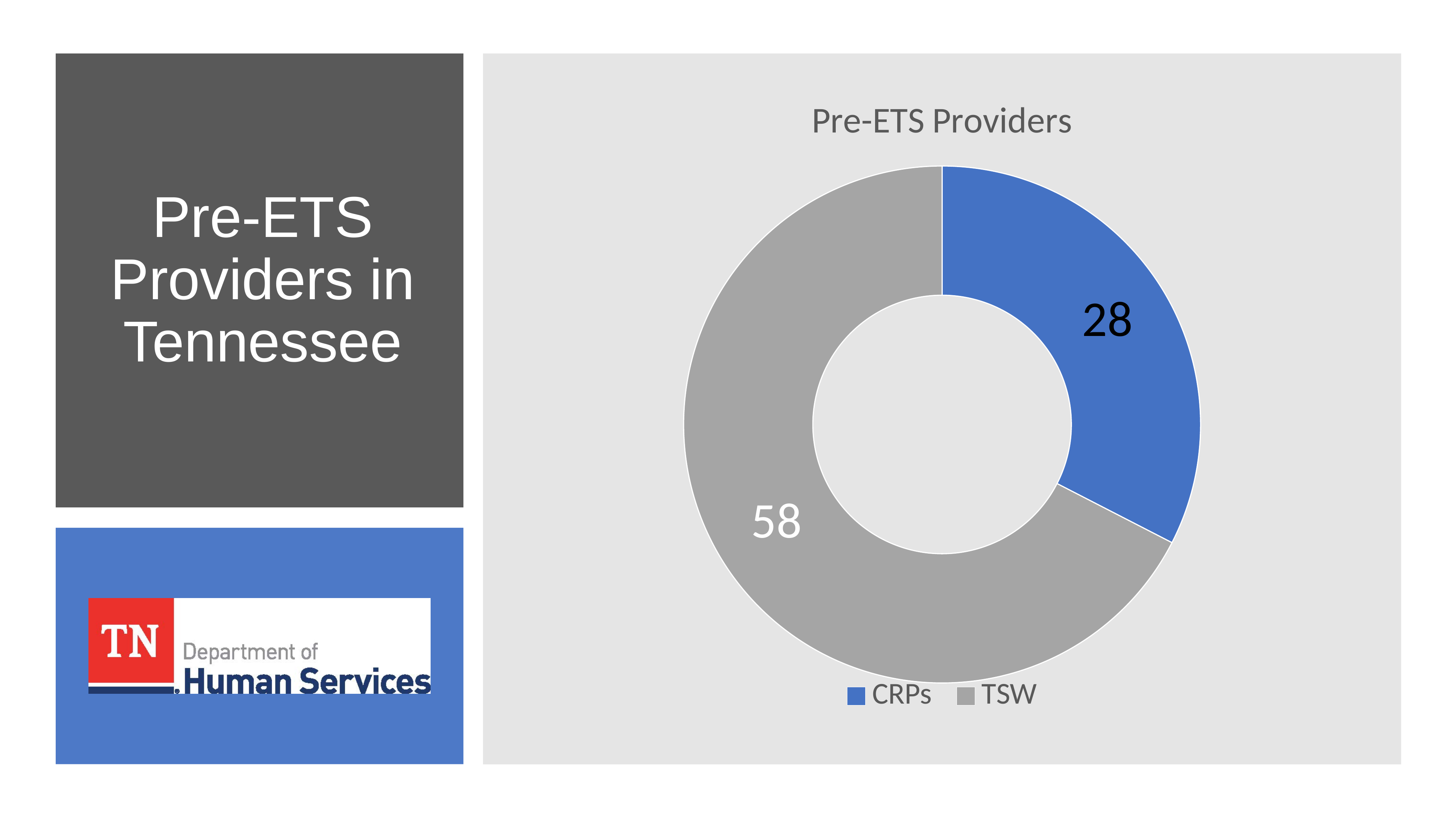
What is the title of the chart on the slide? Pre-ETS Providers What kind of chart is the Pre-ETS Providers chart? Doughnut (pie) chart What is the difference between the TSW and CRPs values in the Pre-ETS Providers chart? 30 What is the value for TSW in the Pre-ETS Providers chart? 58 Which is larger in the Pre-ETS Providers chart, CRPs or TSW? TSW What is the total of the two values shown in the Pre-ETS Providers chart? 86 How many categories are shown in the Pre-ETS Providers chart? 2 What colour represents TSW in the Pre-ETS Providers chart? Grey What is the value for CRPs in the Pre-ETS Providers chart? 28 Which category has the largest slice in the Pre-ETS Providers chart? TSW Which category has the smallest slice in the Pre-ETS Providers chart? CRPs